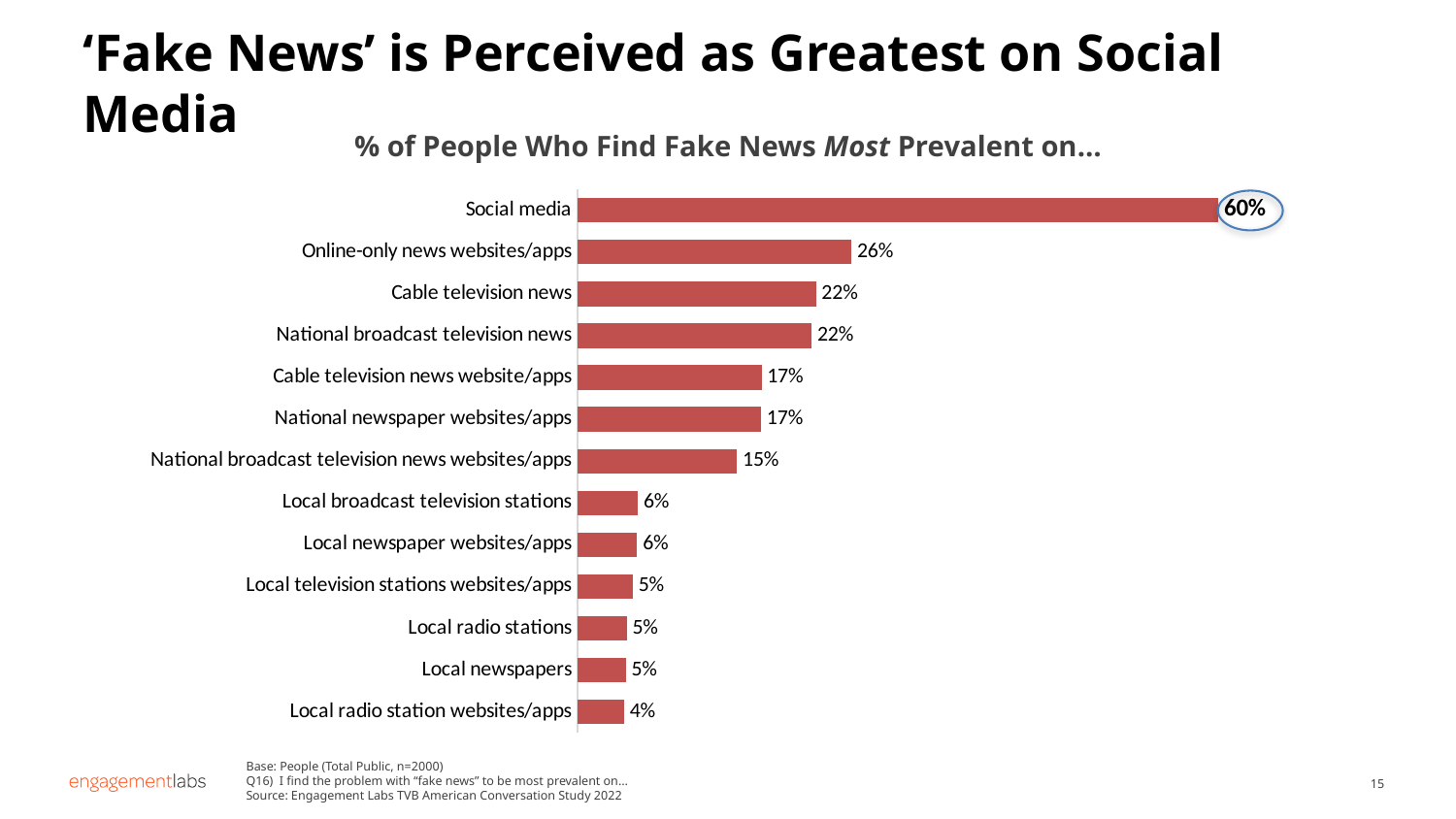
What percentage of people find fake news most prevalent on social media? 60% What is the difference between the values for Social media and Online-only news websites/apps? 34 percentage points How many categories are shown in the chart? 13 What is the difference between the values for Cable television news and Cable television news website/apps? 5 percentage points What kind of chart is shown on the slide? Bar chart What is the value for Local radio station websites/apps? 4% What is the value for Online-only news websites/apps? 26% What is the value for National broadcast television news websites/apps? 15% What is the title of the chart? % of People Who Find Fake News Most Prevalent on… Which category has the highest value? Social media Which category has the lowest value? Local radio station websites/apps Which is larger, the value for Online-only news websites/apps or the value for Cable television news? Online-only news websites/apps